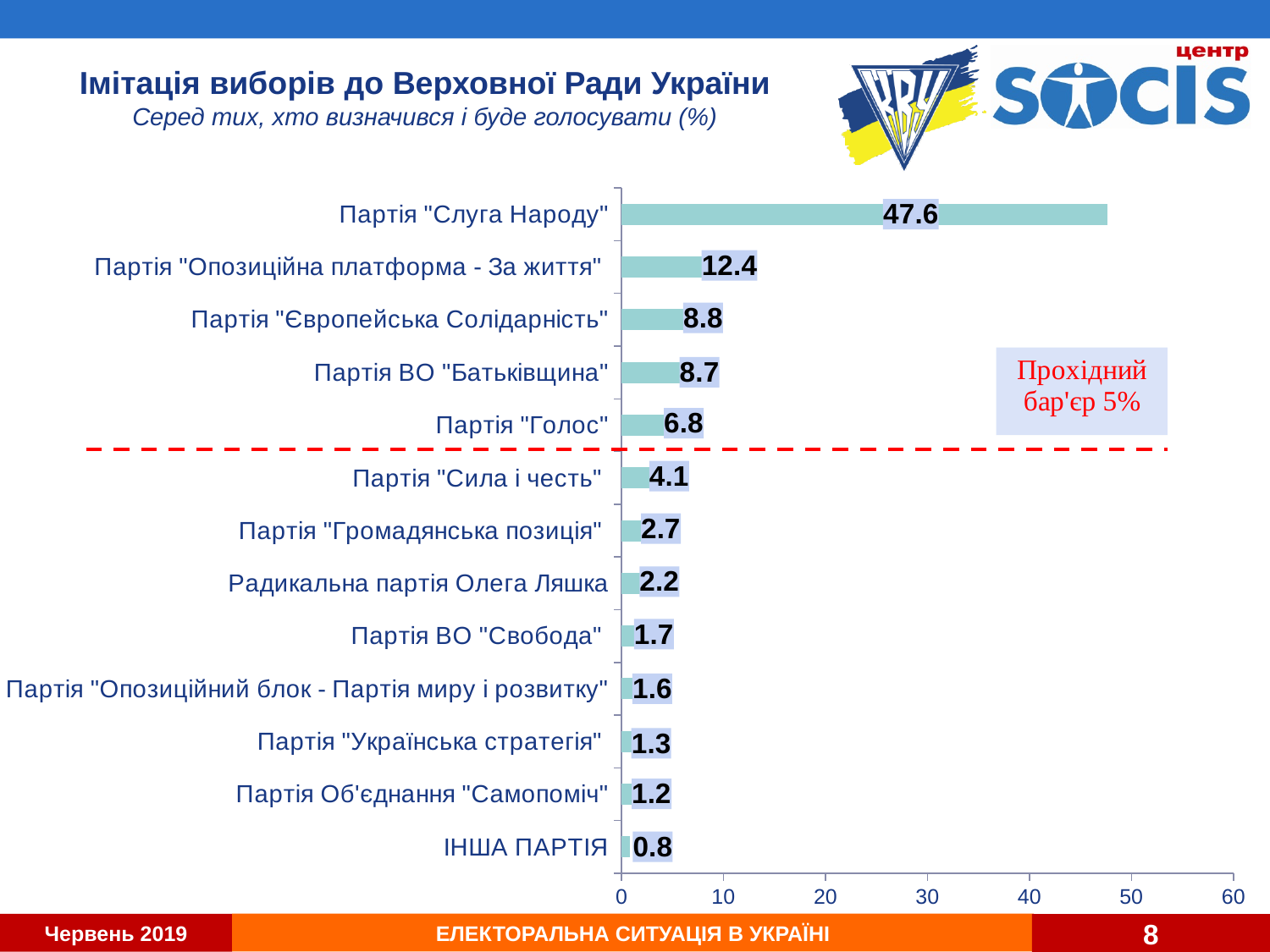
Which category has the lowest value in the chart? ІНША ПАРТІЯ What is the value for Партія "Голос"? 6.8 What is the difference between the values for Партія "Слуга Народу" and Партія "Опозиційна платформа - За життя"? 35.2 What is the value for Радикальна партія Олега Ляшка? 2.2 What kind of chart is shown on the slide? bar chart Which party has the highest value in the chart? Партія "Слуга Народу" What threshold does the red dashed line in the chart mark, according to the label on the slide? Прохідний бар'єр 5% What is the value for Партія "Слуга Народу"? 47.6 Which has a larger value: Партія "Сила і честь" or Партія "Громадянська позиція"? Партія "Сила і честь" What is the value for Партія "Опозиційна платформа - За життя"? 12.4 How many parties (categories) are plotted in the chart? 13 Is the value for Партія "Слуга Народу" greater or less than 40? greater